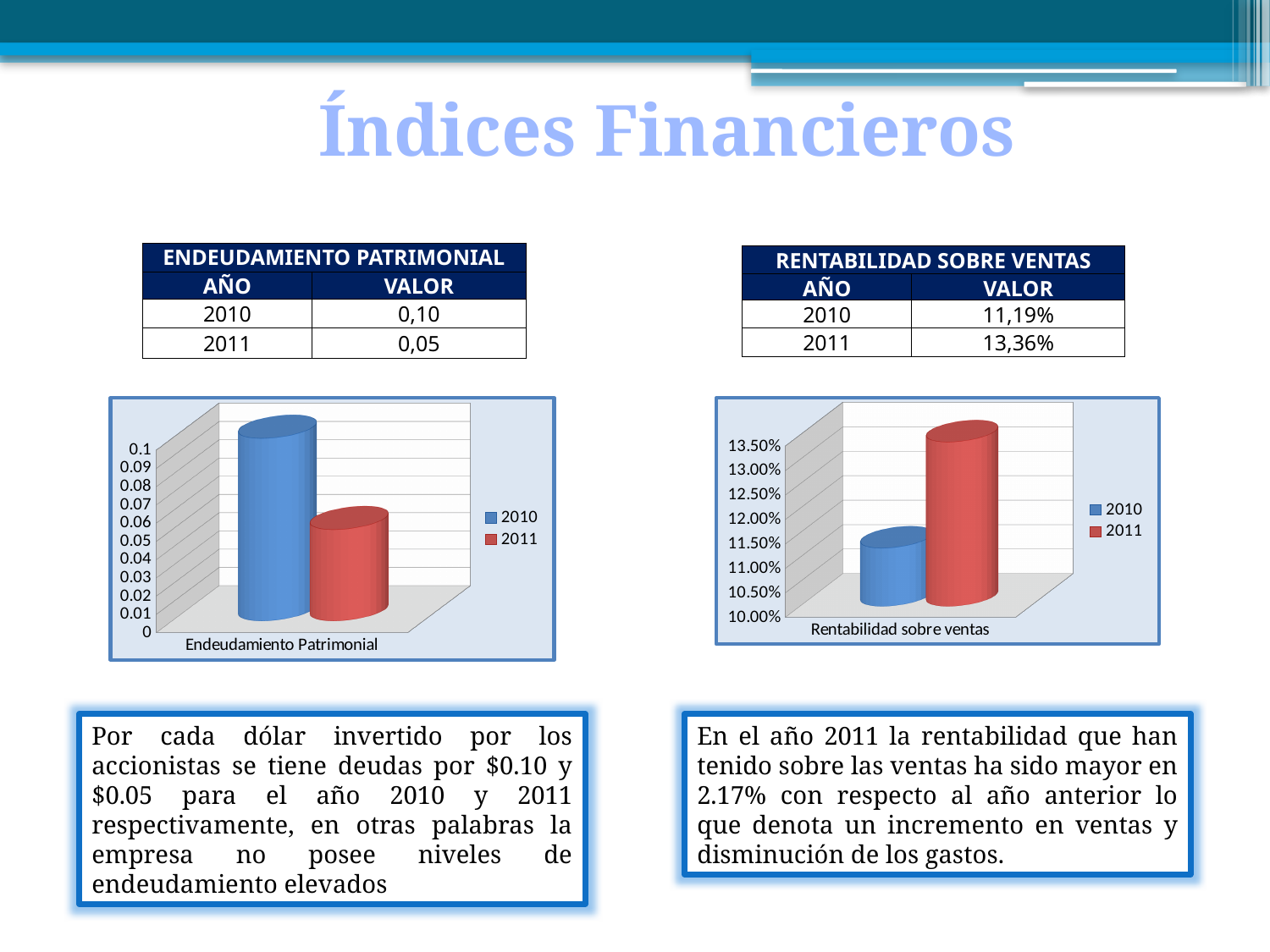
In the right chart, Rentabilidad sobre ventas, which year has the higher value? 2011 In the left chart, Endeudamiento Patrimonial, what is the difference between the 2010 and 2011 values? 0,05 In the right chart, Rentabilidad sobre ventas, what is the value for 2011? 13,36% In the left chart, Endeudamiento Patrimonial, what is the value for 2010? 0,10 In the left chart, Endeudamiento Patrimonial, which year has the larger value, 2010 or 2011? 2010 What kind of chart is the left chart, Endeudamiento Patrimonial? bar chart In the right chart, Rentabilidad sobre ventas, by how much does the 2011 value exceed the 2010 value? 2,17% In the right chart, Rentabilidad sobre ventas, what is the value for 2010? 11,19% In the left chart, Endeudamiento Patrimonial, what is the value for 2011? 0,05 How many series does the legend of the right chart, Rentabilidad sobre ventas, list? 2 In the right chart, Rentabilidad sobre ventas, is the value for 2010 greater or less than 12.00%? less In the left chart, Endeudamiento Patrimonial, is the value for 2011 greater or less than 0.08? less